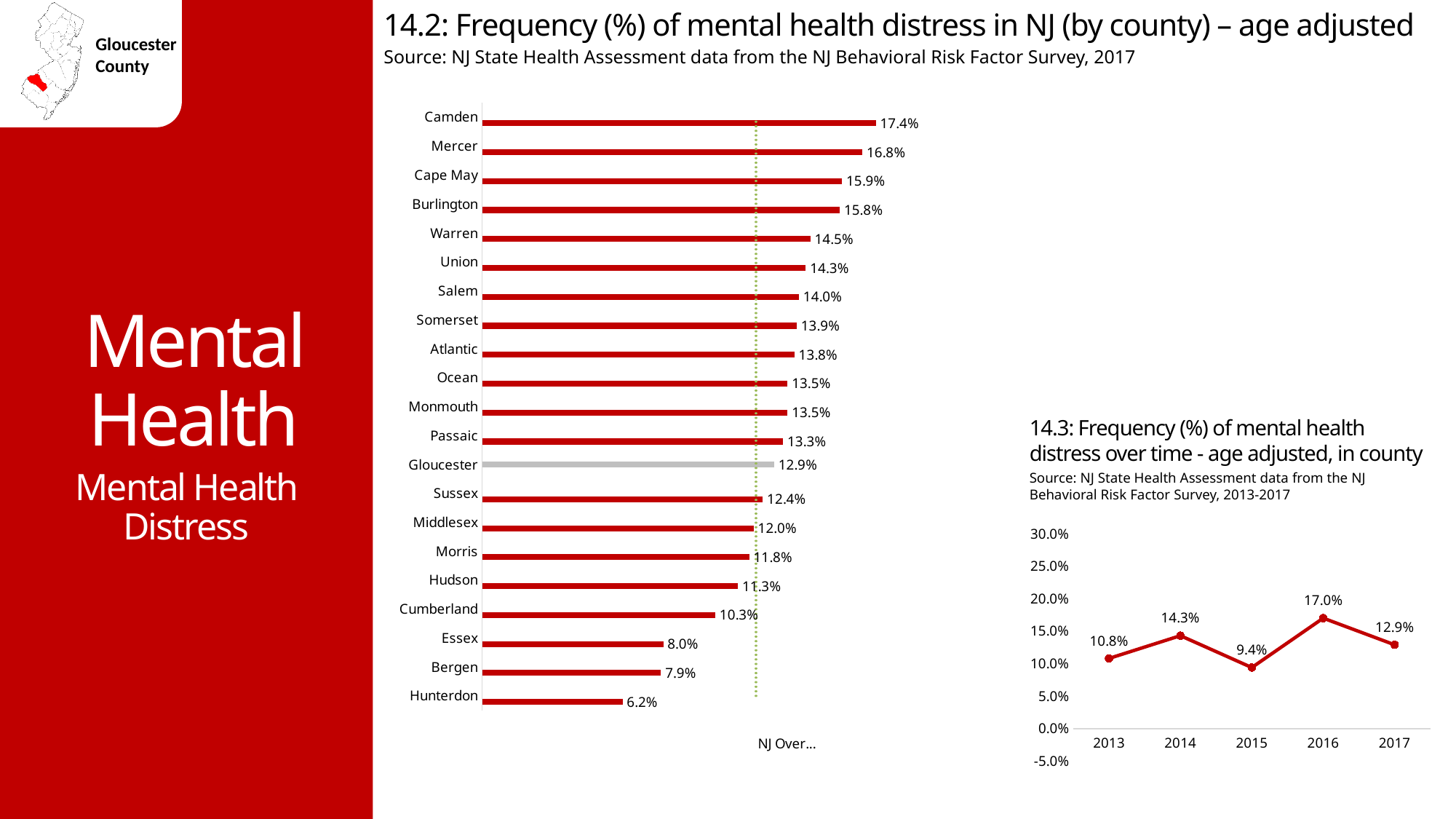
In chart 14.2, what is the frequency of mental health distress for Gloucester County? 12.9% In chart 14.3, what was the frequency of mental health distress in 2016? 17.0% In chart 14.2, what is the difference between the values for Camden and Hunterdon? 11.2% In chart 14.2, how many counties are shown? 21 In chart 14.3, which year had the lowest frequency of mental health distress? 2015 In chart 14.2, which county has a higher value, Essex or Cumberland? Cumberland In chart 14.2, which county has the highest frequency of mental health distress? Camden What kind of chart is chart 14.2? Bar chart In chart 14.3, what is the difference between the 2016 and 2017 values? 4.1% In chart 14.2, what is the value for Mercer County? 16.8% In chart 14.2, which county has the lowest frequency of mental health distress? Hunterdon What kind of chart is chart 14.3? Line chart